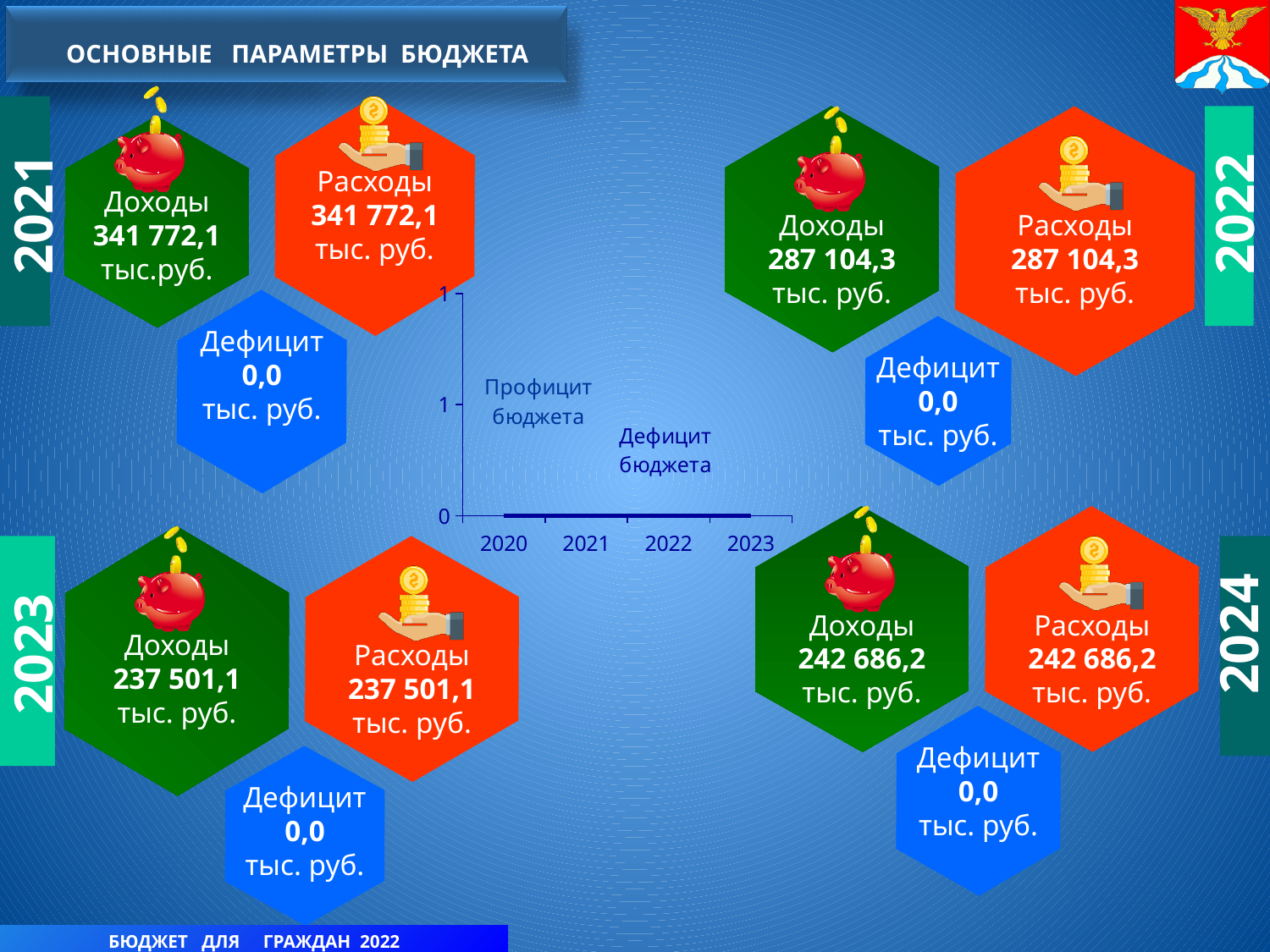
Is the value plotted for 2022 in the chart greater or less than 1? less What value does the plotted line show for 2023 in the chart? 0 What is the first year labelled on the x axis of the chart? 2020 What value does the plotted line show for 2021 in the chart? 0 Does the plotted line in the chart rise, fall or stay flat from 2020 to 2023? stays flat How many years are labelled on the x axis of the chart? 4 What is the last year labelled on the x axis of the chart? 2023 What kind of chart is shown in the centre of the slide? line chart